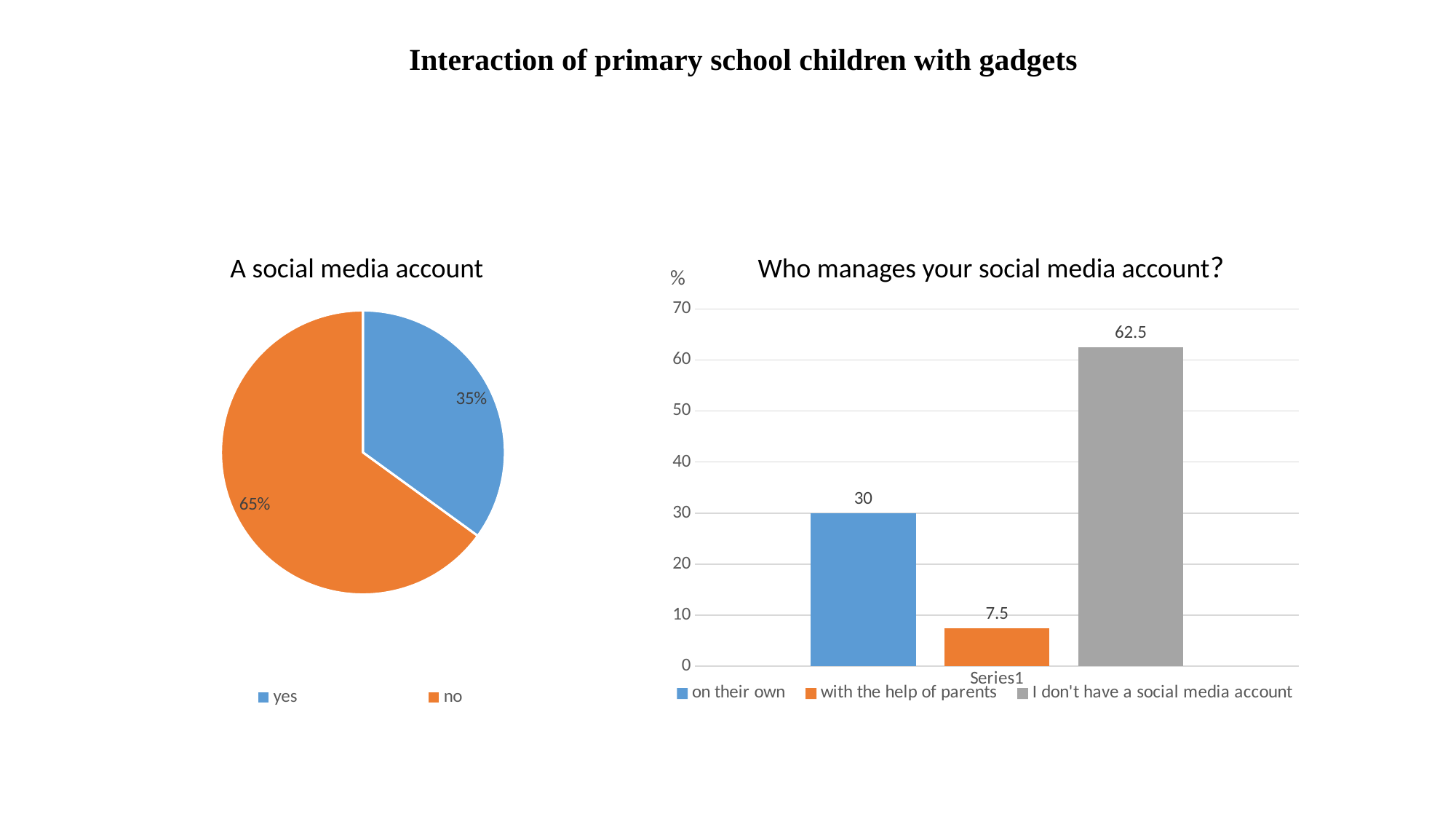
In the 'A social media account' pie chart, what is the difference between the 'no' and 'yes' shares? 30% In the 'Who manages your social media account?' chart, what is the value for 'I don't have a social media account'? 62.5 In the 'Who manages your social media account?' chart, what is the value for 'on their own'? 30 In the 'Who manages your social media account?' chart, what is the value for 'with the help of parents'? 7.5 In the 'Who manages your social media account?' chart, what is the difference between 'I don't have a social media account' and 'on their own'? 32.5 In the 'A social media account' pie chart, what percentage answered 'no'? 65% In the 'A social media account' pie chart, which answer has the larger share? no What kind of chart is 'Who manages your social media account?'? bar chart What kind of chart is 'A social media account'? pie chart In the 'Who manages your social media account?' chart, which category has the lowest value? with the help of parents How many entries does the legend of the 'Who manages your social media account?' chart list? 3 In the 'A social media account' pie chart, what percentage answered 'yes'? 35%